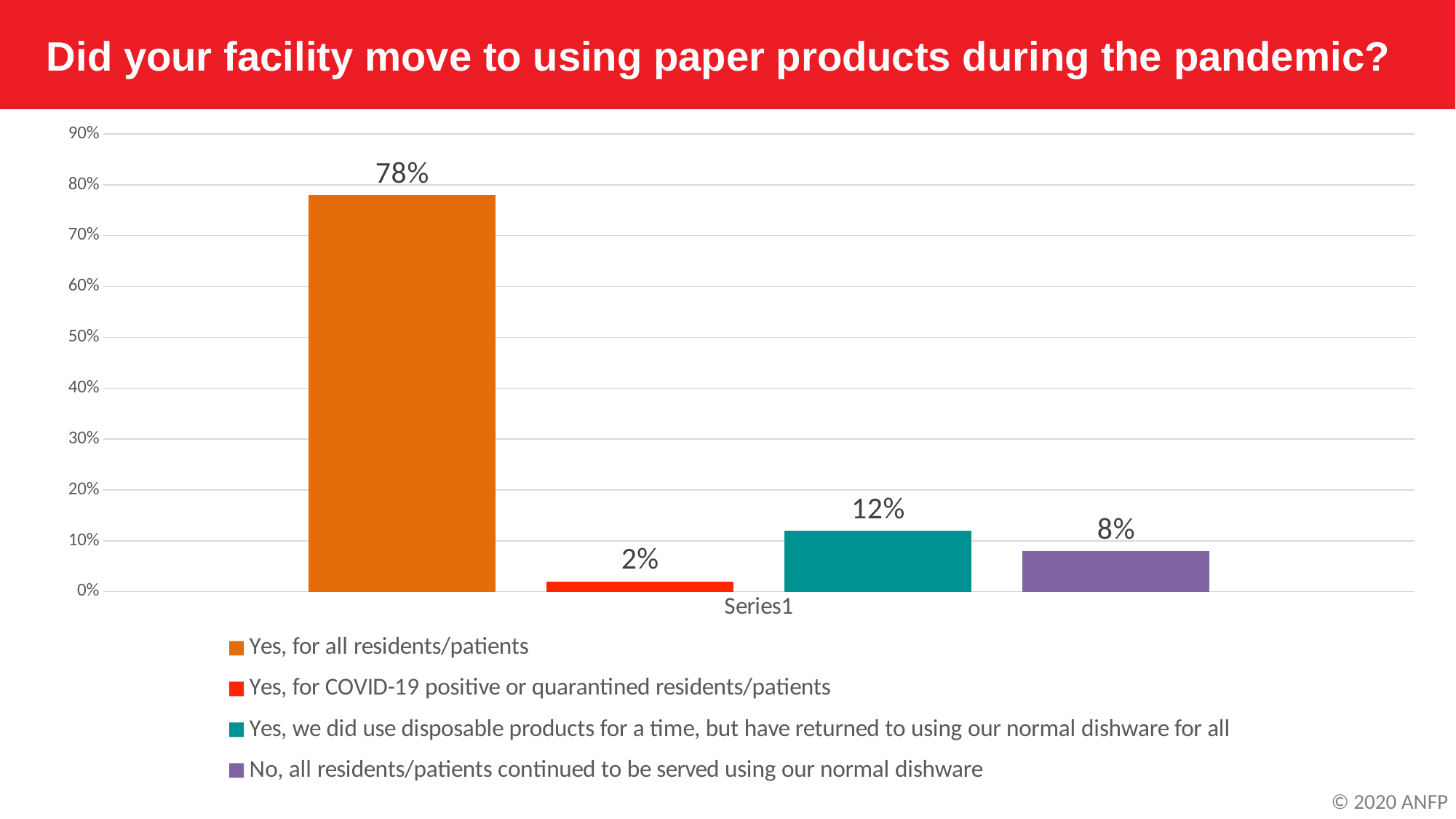
What percentage of facilities used disposable products for a time but returned to normal dishware for all? 12% Which is larger: the percentage that used disposable products for a time but returned to normal dishware, or the percentage that continued with normal dishware throughout? Yes, we did use disposable products for a time, but have returned to using our normal dishware for all Which response has the lowest percentage? Yes, for COVID-19 positive or quarantined residents/patients Which response has the highest percentage? Yes, for all residents/patients What percentage of facilities used paper products only for COVID-19 positive or quarantined residents/patients? 2% What type of chart is shown on the slide? Bar chart What is the difference in percentage points between 'Yes, for all residents/patients' and 'No, all residents/patients continued to be served using our normal dishware'? 70 percentage points What percentage of facilities continued serving all residents/patients with normal dishware? 8% Is the value for 'Yes, for all residents/patients' greater or less than 70%? greater How many response categories are shown in the legend? 4 What colour is the bar for 'Yes, for all residents/patients'? Orange What percentage of facilities moved to paper products for all residents/patients? 78%